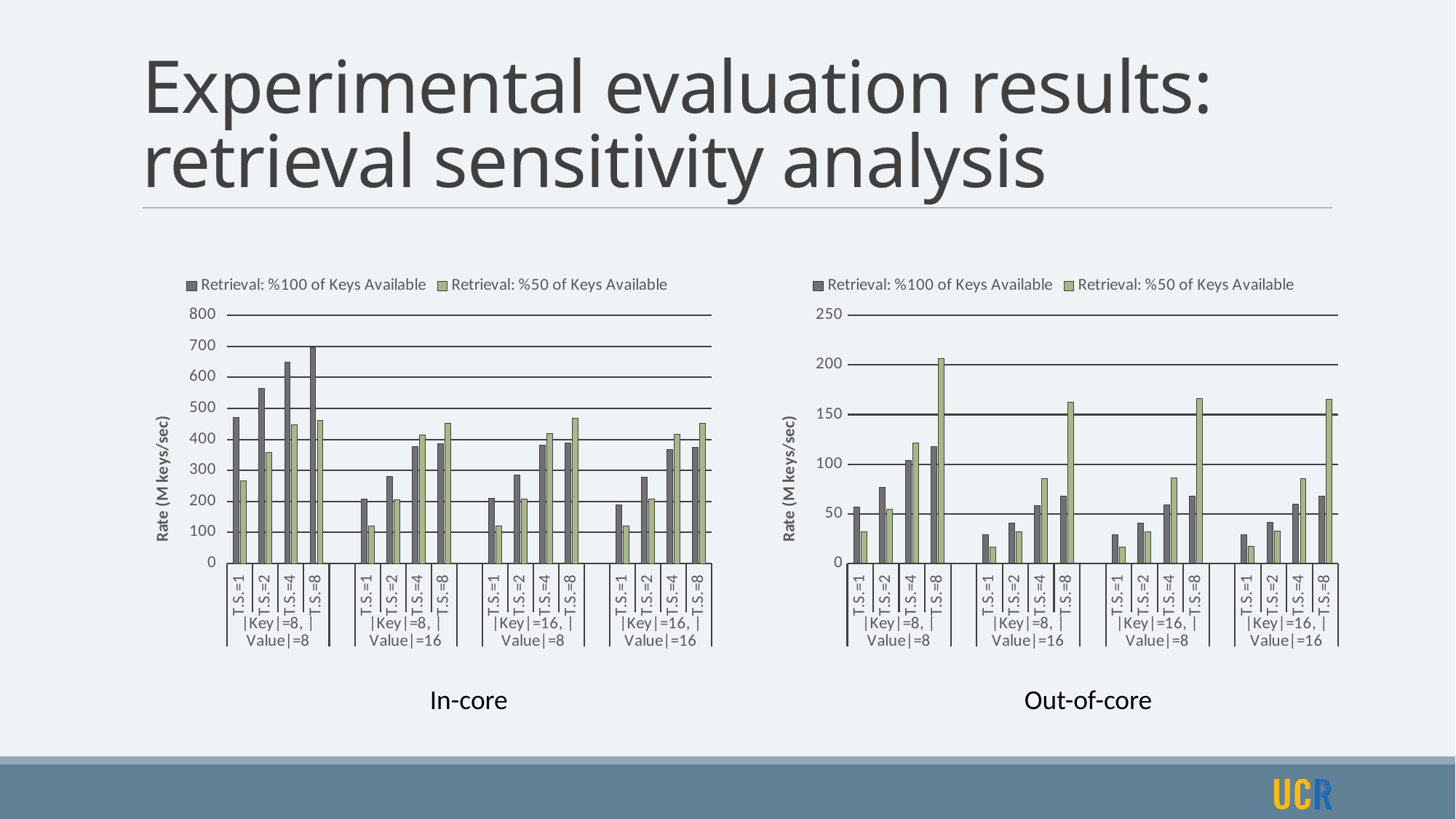
In the In-core chart, how many T.S. categories are plotted along the x axis in total? 16 In the In-core chart, is the value for Retrieval: %50 of Keys Available at |Key|=8, |Value|=8, T.S.=1 greater or less than 300? less What is the y-axis title of the Out-of-core chart? Rate (M keys/sec) In the In-core chart, is the value for Retrieval: %100 of Keys Available at |Key|=8, |Value|=8, T.S.=8 greater or less than 600? greater In the In-core chart, which series has the larger value at |Key|=8, |Value|=16, T.S.=8? Retrieval: %50 of Keys Available What kind of chart is the In-core chart on the left? bar chart In the In-core chart, which category has the highest value for Retrieval: %100 of Keys Available? |Key|=8, |Value|=8, T.S.=8 How many series does the legend of the Out-of-core chart list? 2 In the In-core chart, which series has the larger value at |Key|=8, |Value|=8, T.S.=1? Retrieval: %100 of Keys Available In the Out-of-core chart, is the value for Retrieval: %100 of Keys Available at |Key|=8, |Value|=8, T.S.=8 greater or less than 100? greater In the Out-of-core chart, which category has the highest value for Retrieval: %50 of Keys Available? |Key|=8, |Value|=8, T.S.=8